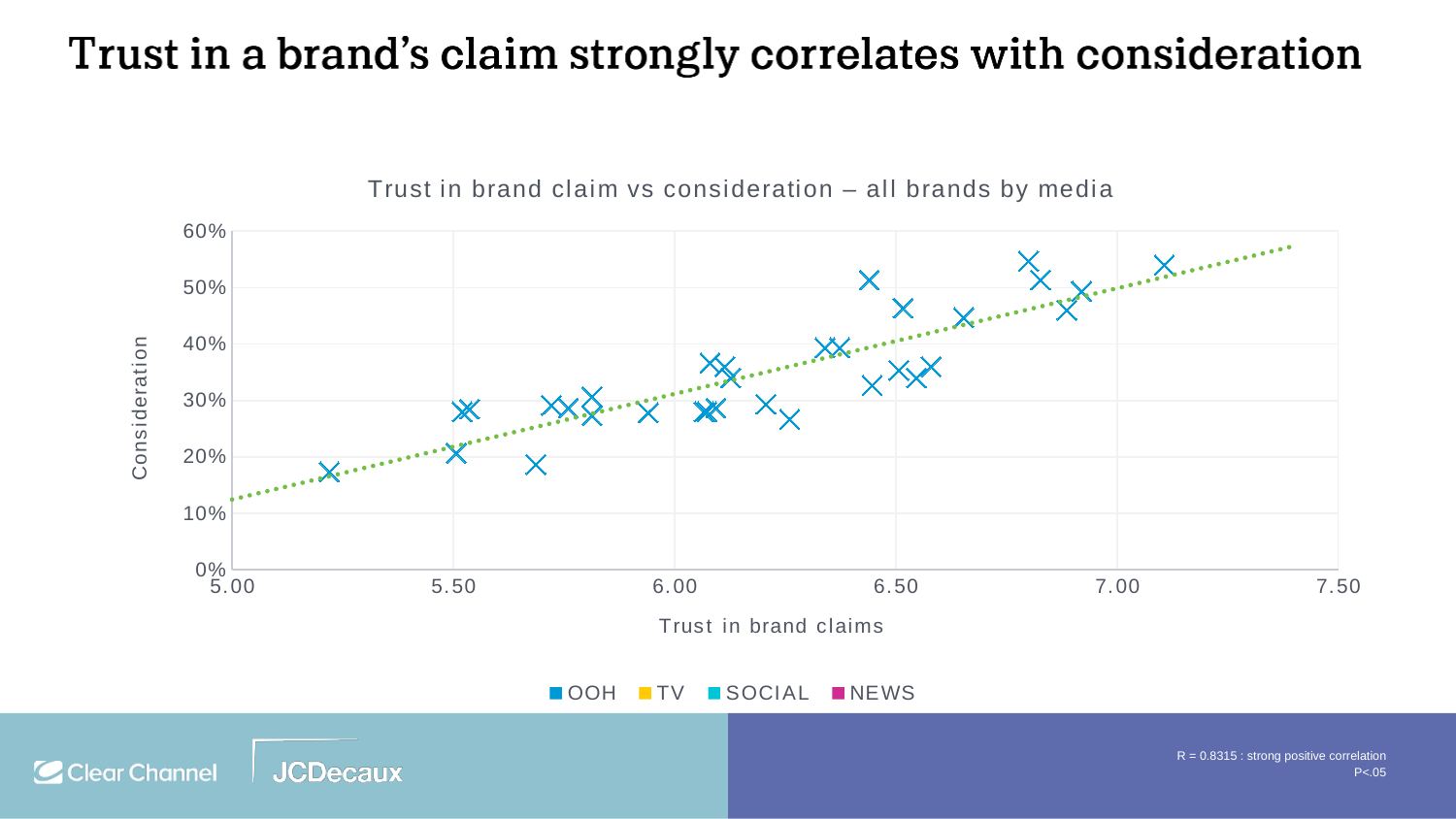
Is the highest plotted consideration value greater or less than 60%? less Which entries are listed in the chart legend? OOH, TV, SOCIAL, NEWS Do the plotted consideration values generally rise or fall as trust in brand claims increases along the x axis? rise Is the lowest trust in brand claims value among the plotted points greater or less than 5.50? less What kind of chart is shown on the slide? scatter chart Is the highest trust in brand claims value among the plotted points greater or less than 7.00? greater Does the dotted trend line on the chart slope upward or downward from left to right? upward How many series does the legend list? 4 What is the title of the chart? Trust in brand claim vs consideration – all brands by media